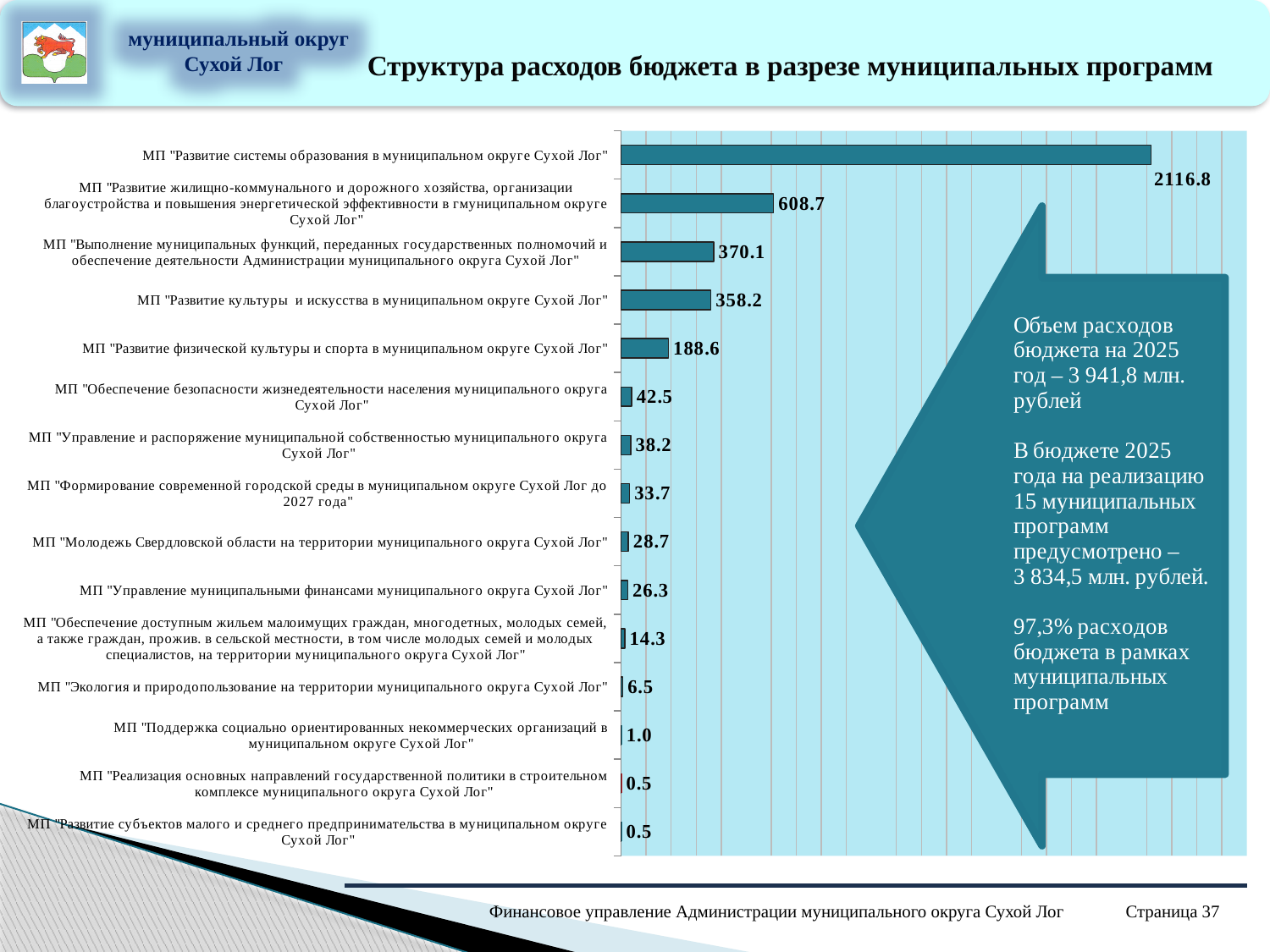
What is the value for МП "Экология и природопользование на территории муниципального округа Сухой Лог"? 6.5 What is the value for МП "Развитие системы образования в муниципальном округе Сухой Лог"? 2116.8 What kind of chart is shown on the slide? Bar chart What is the value for МП "Развитие физической культуры и спорта в муниципальном округе Сухой Лог"? 188.6 Which is larger: the value for МП "Обеспечение безопасности жизнедеятельности населения..." or МП "Управление и распоряжение муниципальной собственностью..."? МП "Обеспечение безопасности жизнедеятельности населения муниципального округа Сухой Лог" What is the lowest value shown on the chart? 0.5 What is the difference between the values for МП "Развитие системы образования в муниципальном округе Сухой Лог" and МП "Развитие жилищно-коммунального и дорожного хозяйства..."? 1508.1 What is the difference between the values for МП "Выполнение муниципальных функций..." (370.1) and МП "Развитие культуры и искусства в муниципальном округе Сухой Лог"? 11.9 What is the value for МП "Управление муниципальными финансами муниципального округа Сухой Лог"? 26.3 Which municipal programme has the highest value on the chart? МП "Развитие системы образования в муниципальном округе Сухой Лог" How many municipal programmes (categories) are shown on the chart? 15 What is the title of the slide containing the chart? Структура расходов бюджета в разрезе муниципальных программ